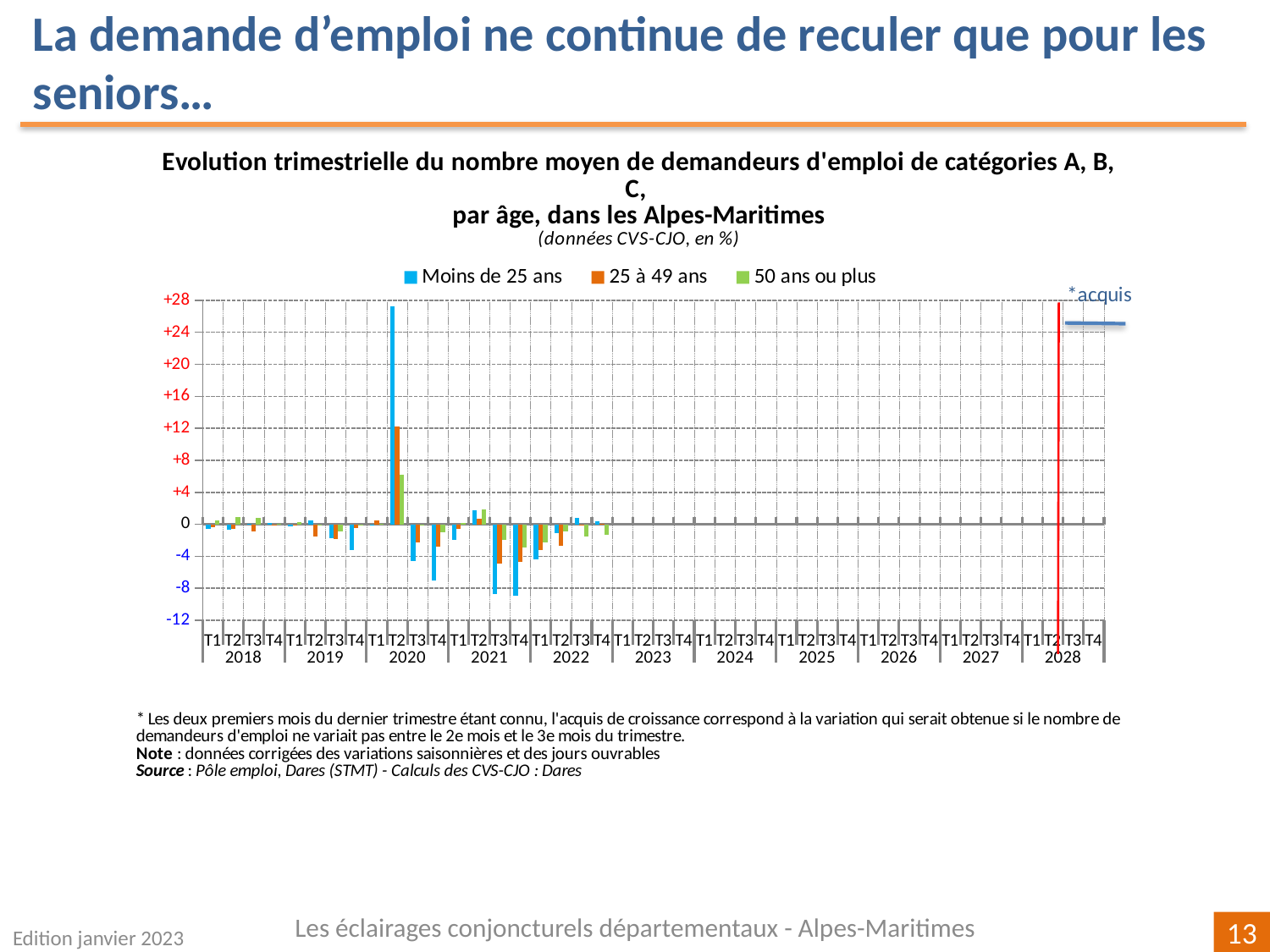
In which quarter does the 'Moins de 25 ans' series reach its highest value? T2 2020 What colour represents the 'Moins de 25 ans' series? Blue How many years are labelled along the x axis? 11 In T2 2020, which series has the larger value: 'Moins de 25 ans' or '50 ans ou plus'? Moins de 25 ans Is the value for '25 à 49 ans' in T2 2020 greater or less than +8? greater Is the value for 'Moins de 25 ans' in T3 2021 greater or less than -4? less Which age groups are listed in the legend? Moins de 25 ans, 25 à 49 ans, 50 ans ou plus How many series does the legend list? 3 What kind of chart is shown on the slide? Bar chart Is the value for 'Moins de 25 ans' in T2 2020 greater or less than +24? greater What is the highest value shown on the vertical axis? +28